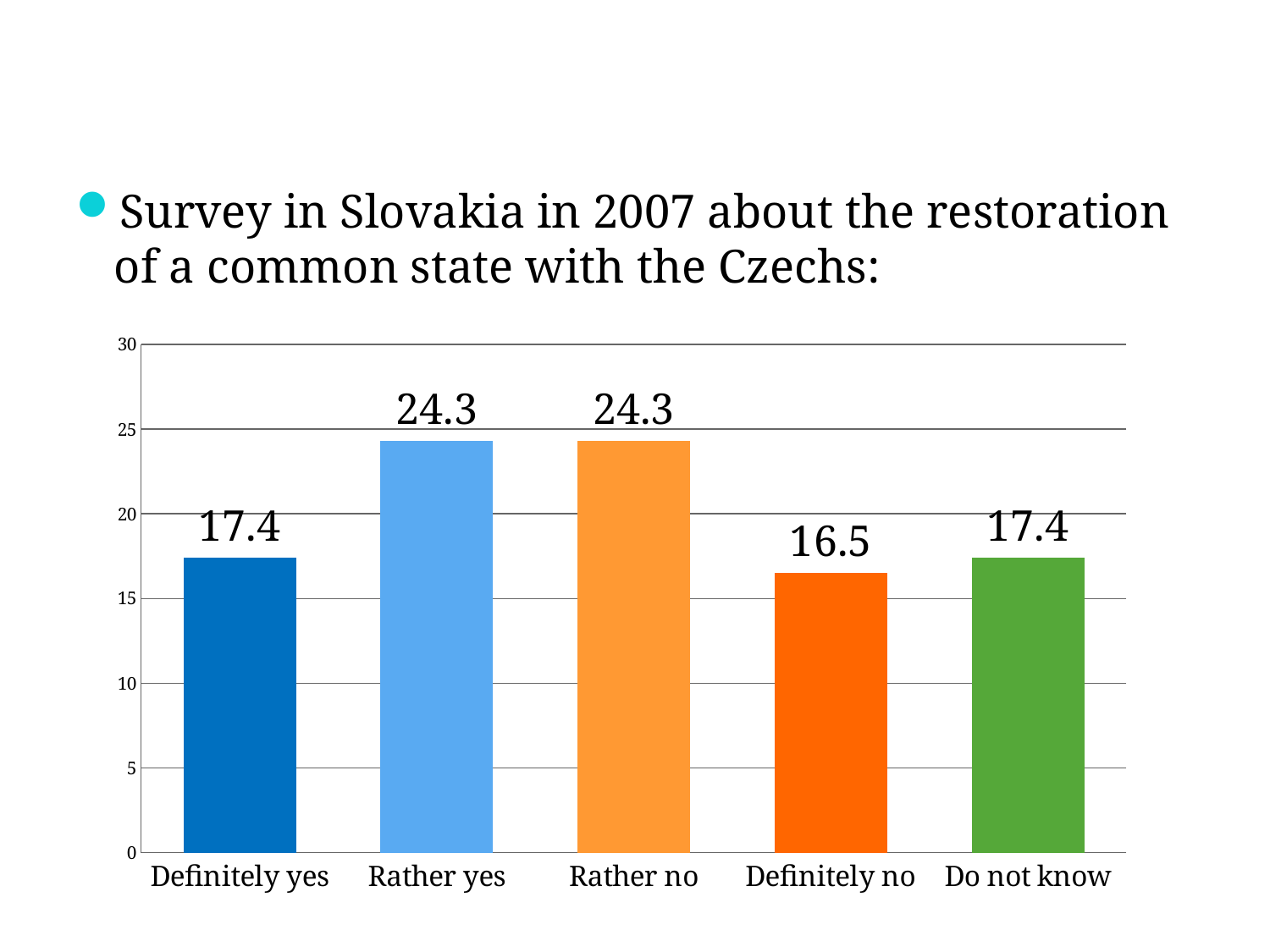
What is the difference between the values for Rather yes and Definitely yes? 6.9 What is the value for Definitely yes? 17.4 What colour is the bar for Do not know? Green What is the value for Rather yes? 24.3 What is the value for Definitely no? 16.5 Which is larger, the value for Definitely yes or the value for Definitely no? Definitely yes What kind of chart is shown on the slide? Bar chart Which category has the lowest value? Definitely no Is the value for Rather no greater or less than 20? greater What is the difference between the values for Rather no and Definitely no? 7.8 What is the value for Do not know? 17.4 How many categories are shown on the x axis? 5